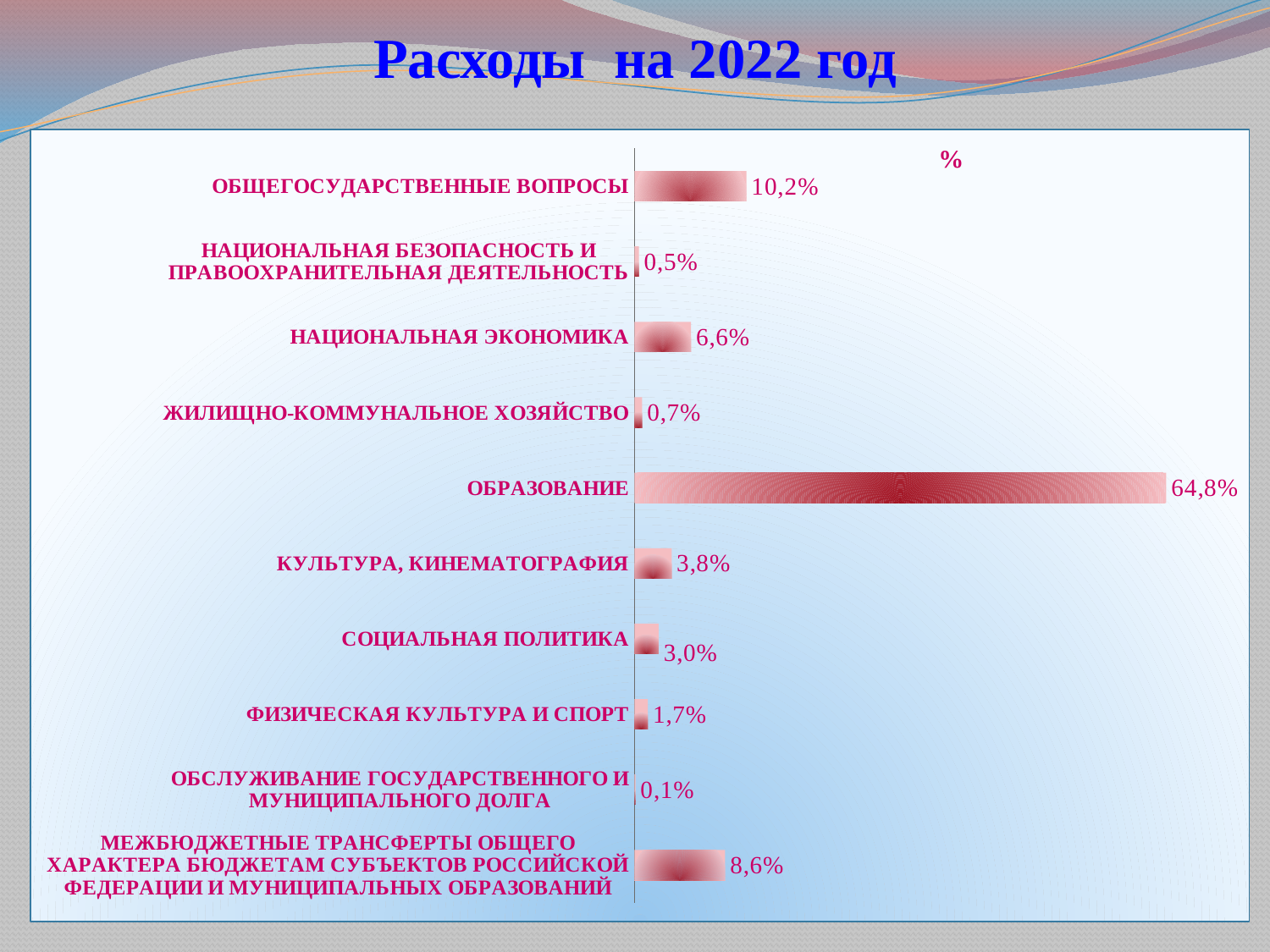
What is the value for НАЦИОНАЛЬНАЯ ЭКОНОМИКА? 6,6% What is the difference between the values for ОБРАЗОВАНИЕ and МЕЖБЮДЖЕТНЫЕ ТРАНСФЕРТЫ ОБЩЕГО ХАРАКТЕРА БЮДЖЕТАМ СУБЪЕКТОВ РОССИЙСКОЙ ФЕДЕРАЦИИ И МУНИЦИПАЛЬНЫХ ОБРАЗОВАНИЙ? 56,2% What kind of chart is shown on the slide? bar chart Which is larger, the value for КУЛЬТУРА, КИНЕМАТОГРАФИЯ or the value for СОЦИАЛЬНАЯ ПОЛИТИКА? КУЛЬТУРА, КИНЕМАТОГРАФИЯ Which category has the highest value? ОБРАЗОВАНИЕ What is the difference between the values for ОБЩЕГОСУДАРСТВЕННЫЕ ВОПРОСЫ and НАЦИОНАЛЬНАЯ ЭКОНОМИКА? 3,6% What is the value for ФИЗИЧЕСКАЯ КУЛЬТУРА И СПОРТ? 1,7% What is the title of the slide? Расходы на 2022 год How many categories are shown in the chart? 10 What is the value for ОБЩЕГОСУДАРСТВЕННЫЕ ВОПРОСЫ? 10,2% Which category has the lowest value? ОБСЛУЖИВАНИЕ ГОСУДАРСТВЕННОГО И МУНИЦИПАЛЬНОГО ДОЛГА What is the value for ОБРАЗОВАНИЕ? 64,8%